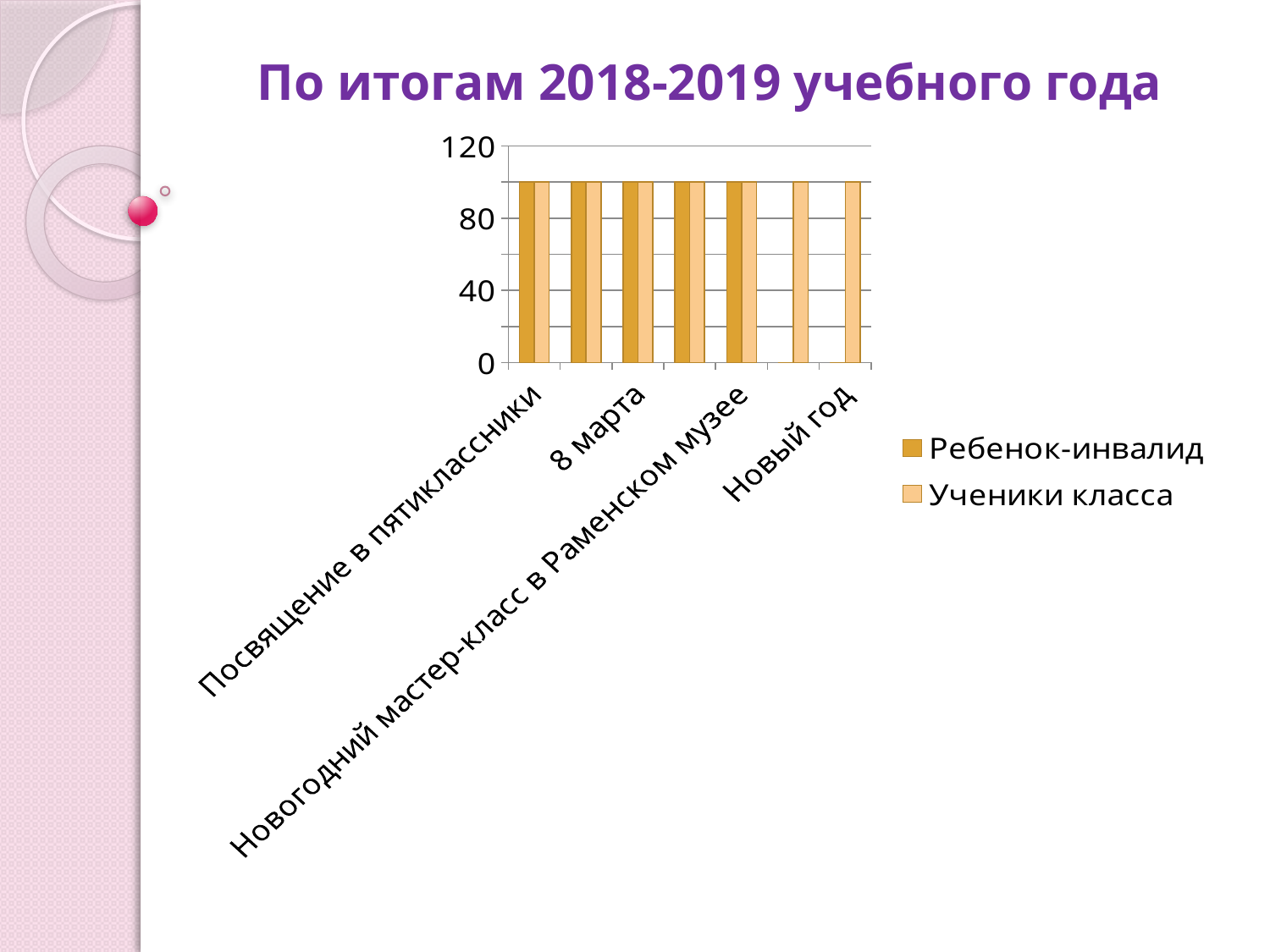
At Новый год, which series has the larger value, Ребенок-инвалид or Ученики класса? Ученики класса What is the highest value shown on the vertical axis? 120 Is the value for Ребенок-инвалид at Посвящение в пятиклассники greater or less than 80? greater What kind of chart is shown on the slide? bar chart Is the value for Ученики класса at 8 марта greater or less than 80? greater What is the title of the slide above the chart? По итогам 2018-2019 учебного года Is the value for Ребенок-инвалид at Новогодний мастер-класс в Раменском музее greater or less than 40? greater Which series is shown in the lighter colour in the legend? Ученики класса How many series does the legend list? 2